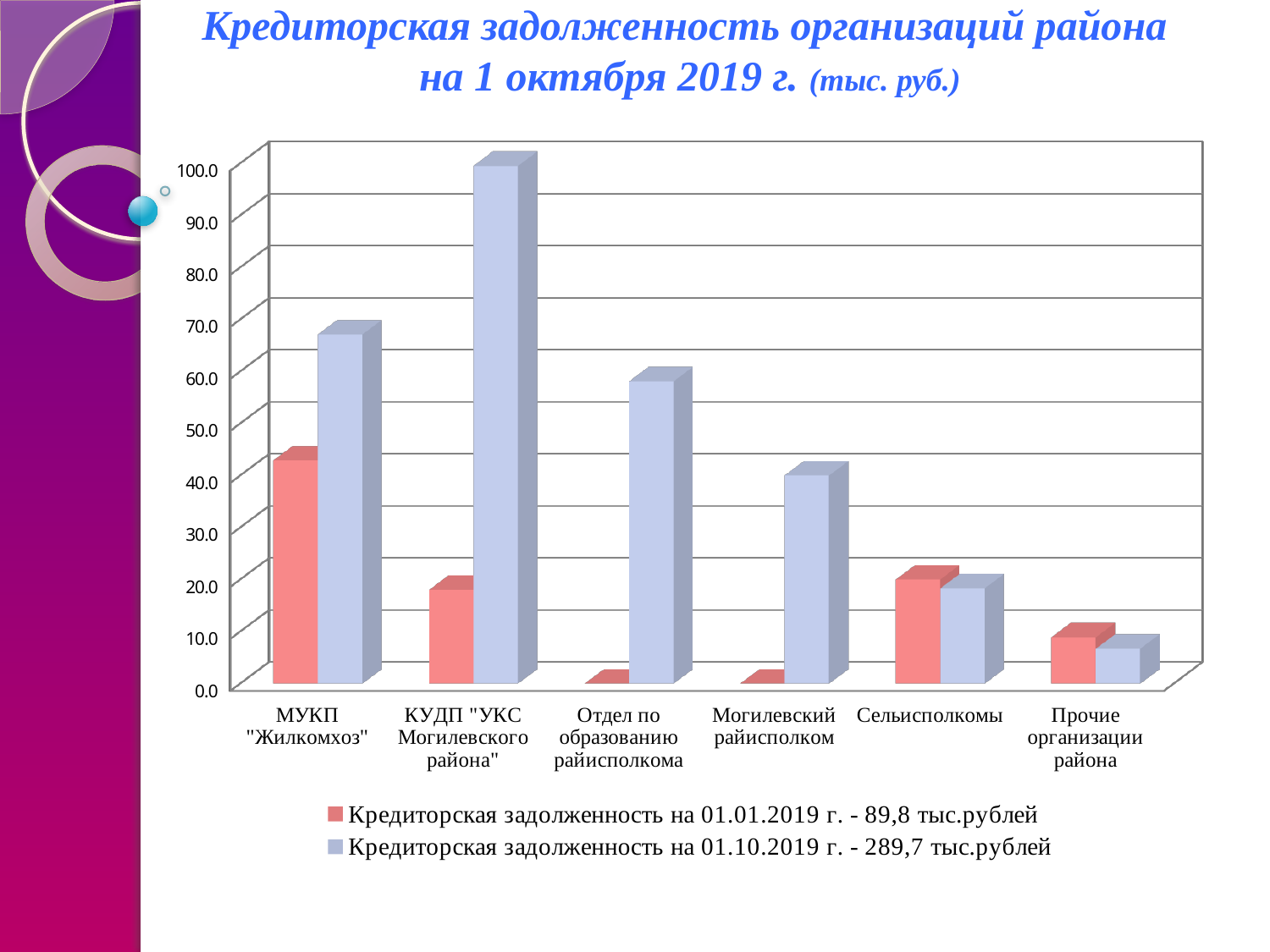
Which category has the lowest value for the series 'Кредиторская задолженность на 01.10.2019 г.'? Прочие организации района How many series does the legend list? 2 Which category has the highest value for the series 'Кредиторская задолженность на 01.10.2019 г.'? КУДП "УКС Могилевского района" Which is larger for 01.10.2019: the value for Отдел по образованию райисполкома or for Могилевский райисполком? Отдел по образованию райисполкома According to the legend, what is the total creditor debt on 01.10.2019? 289,7 тыс.рублей How many organisation categories are shown on the x axis? 6 What kind of chart is shown on the slide? bar chart Is the value for Отдел по образованию райисполкома on 01.10.2019 greater or less than 50.0? greater Is the value for КУДП "УКС Могилевского района" on 01.01.2019 greater or less than 30.0? less Which category has the highest value for the series 'Кредиторская задолженность на 01.01.2019 г.'? МУКП "Жилкомхоз" Is the value for МУКП "Жилкомхоз" on 01.10.2019 greater or less than 60.0? greater According to the legend, what is the total creditor debt on 01.01.2019? 89,8 тыс.рублей